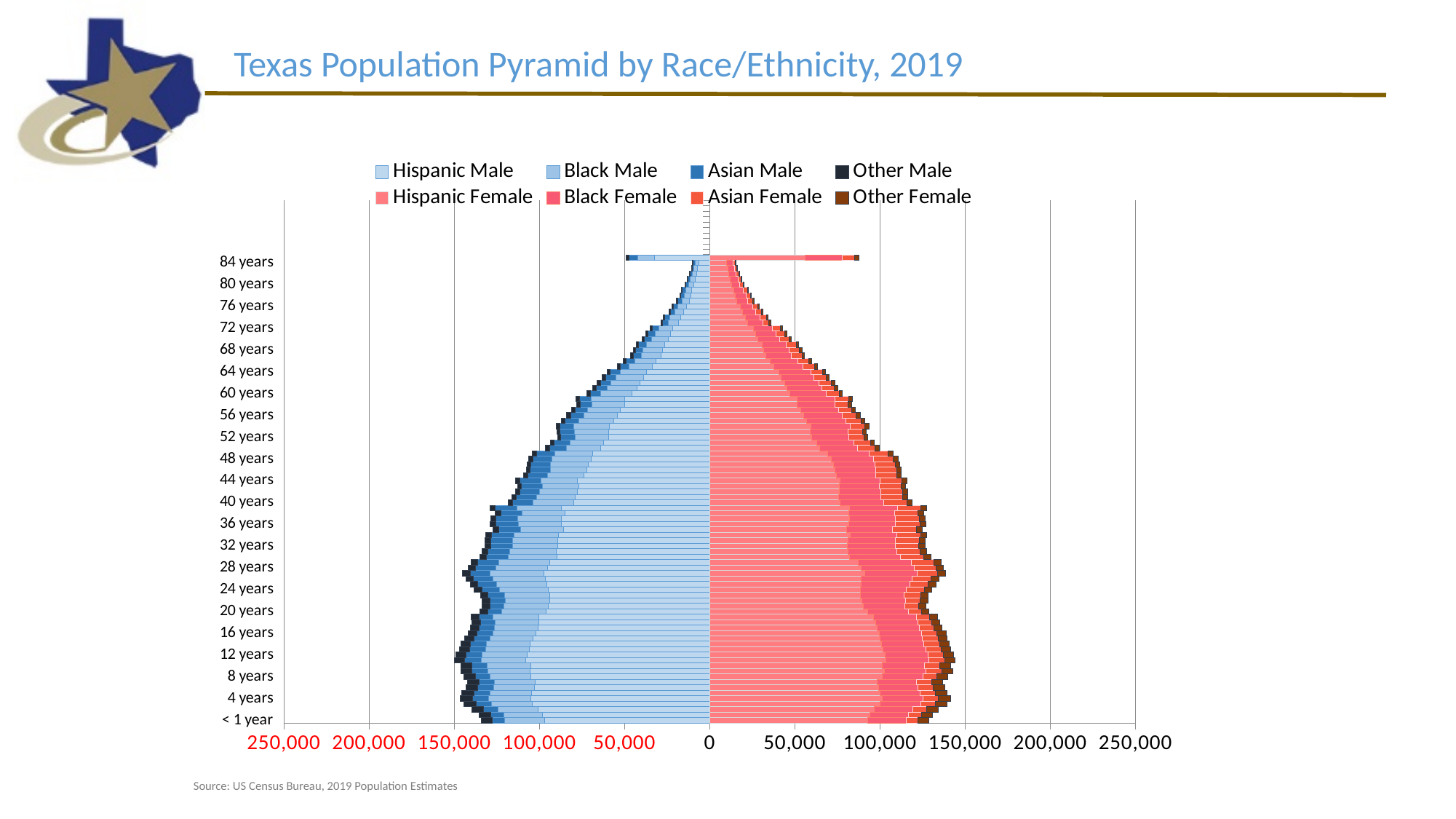
Is the total male bar for 84 years greater or less than 100,000? less What kind of chart is shown on the slide? Bar chart (population pyramid) Is the total female bar for 12 years greater or less than 100,000? greater What is the title of the chart? Texas Population Pyramid by Race/Ethnicity, 2019 Is the total male bar for 76 years greater or less than 50,000? less Which legend entries represent the female population? Hispanic Female, Black Female, Asian Female, Other Female How many series does the legend list? 8 At 84 years, which is larger: the total male bar or the total female bar? Female Moving from the youngest ages at the bottom to the oldest ages at the top, do the bar lengths generally increase or decrease? Decrease On the male side, which total bar is longer: 28 years or 76 years? 28 years